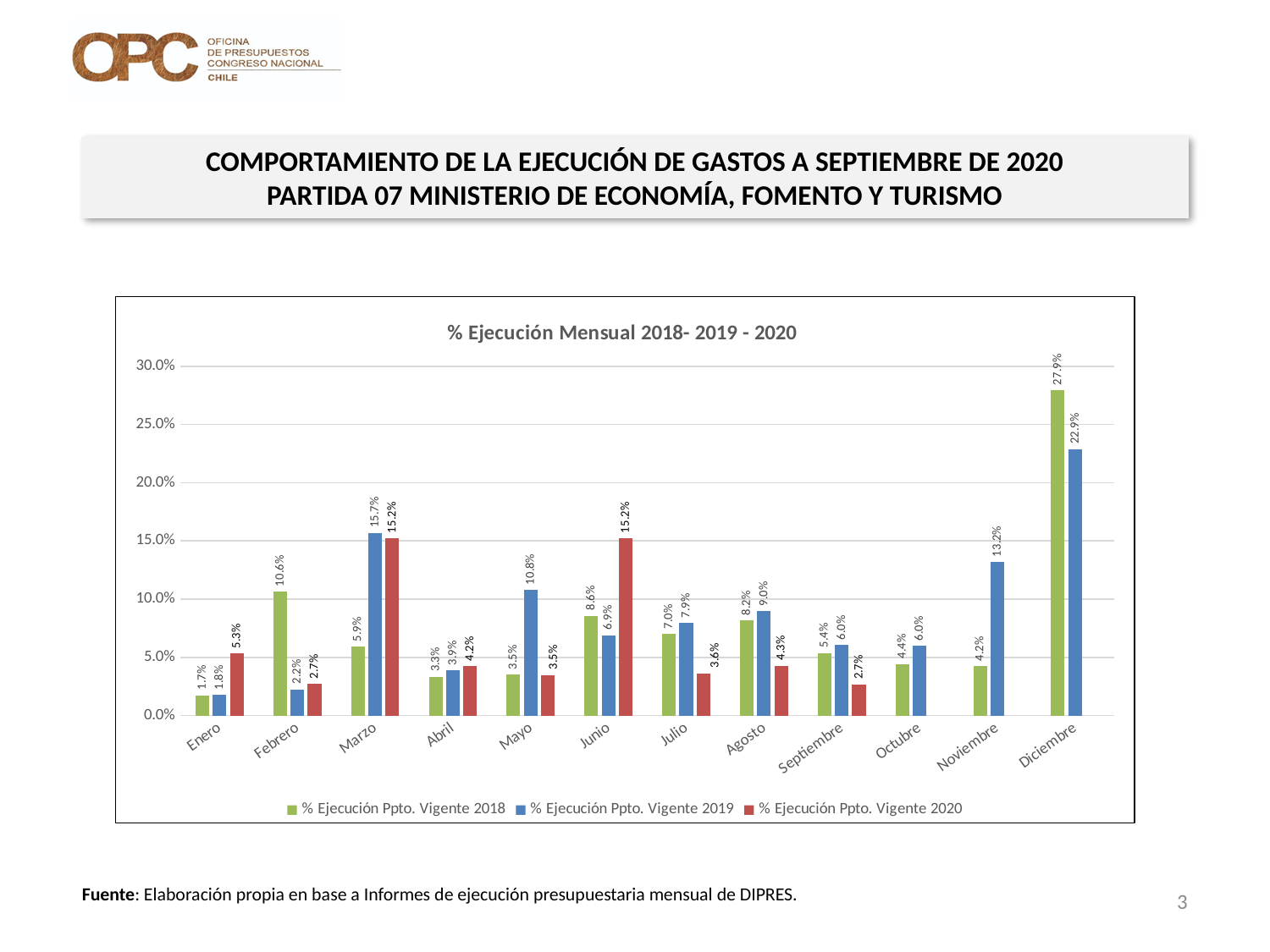
What is the value for % Ejecución Ppto. Vigente 2018 in Febrero? 10.6% What is the value for % Ejecución Ppto. Vigente 2019 in Marzo? 15.7% What is the title of the chart? % Ejecución Mensual 2018- 2019 - 2020 Which month has the highest value for % Ejecución Ppto. Vigente 2018? Diciembre What is the value for % Ejecución Ppto. Vigente 2020 in Junio? 15.2% Which month has the lowest value for % Ejecución Ppto. Vigente 2019? Enero How many series does the legend list? 3 Is the value for % Ejecución Ppto. Vigente 2019 in Noviembre greater or less than 10.0%? greater Which is larger in Mayo: the 2019 value or the 2018 value? 2019 What kind of chart is shown on the slide? Bar chart How many months are shown on the x axis? 12 What is the difference between the 2018 and 2019 values in Diciembre? 5.0%